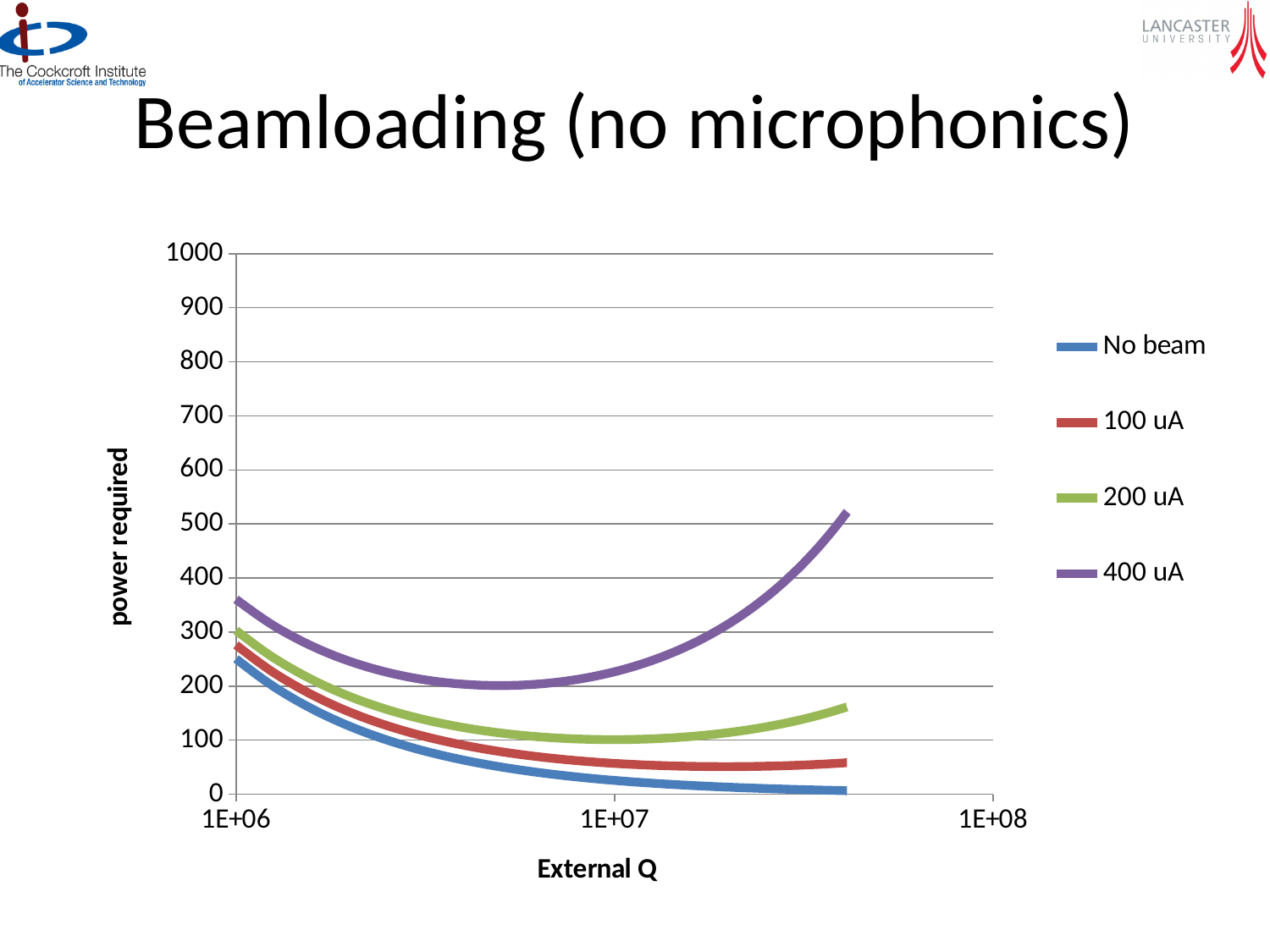
What are the series names listed in the legend? No beam, 100 uA, 200 uA, 400 uA Is the value for 200 uA at External Q 1E+07 greater or less than 200? less Does the No beam curve rise or fall as External Q increases? fall Is the value for No beam at External Q 1E+06 greater or less than 200? greater Which series has the highest power required at the right-hand end of the curves? 400 uA Is the value for 400 uA at External Q 1E+06 greater or less than 300? greater How many series does the legend list? 4 What is the title of the x axis? External Q What kind of chart is shown on the slide? line chart At External Q 1E+06, which series has the higher value, 400 uA or No beam? 400 uA